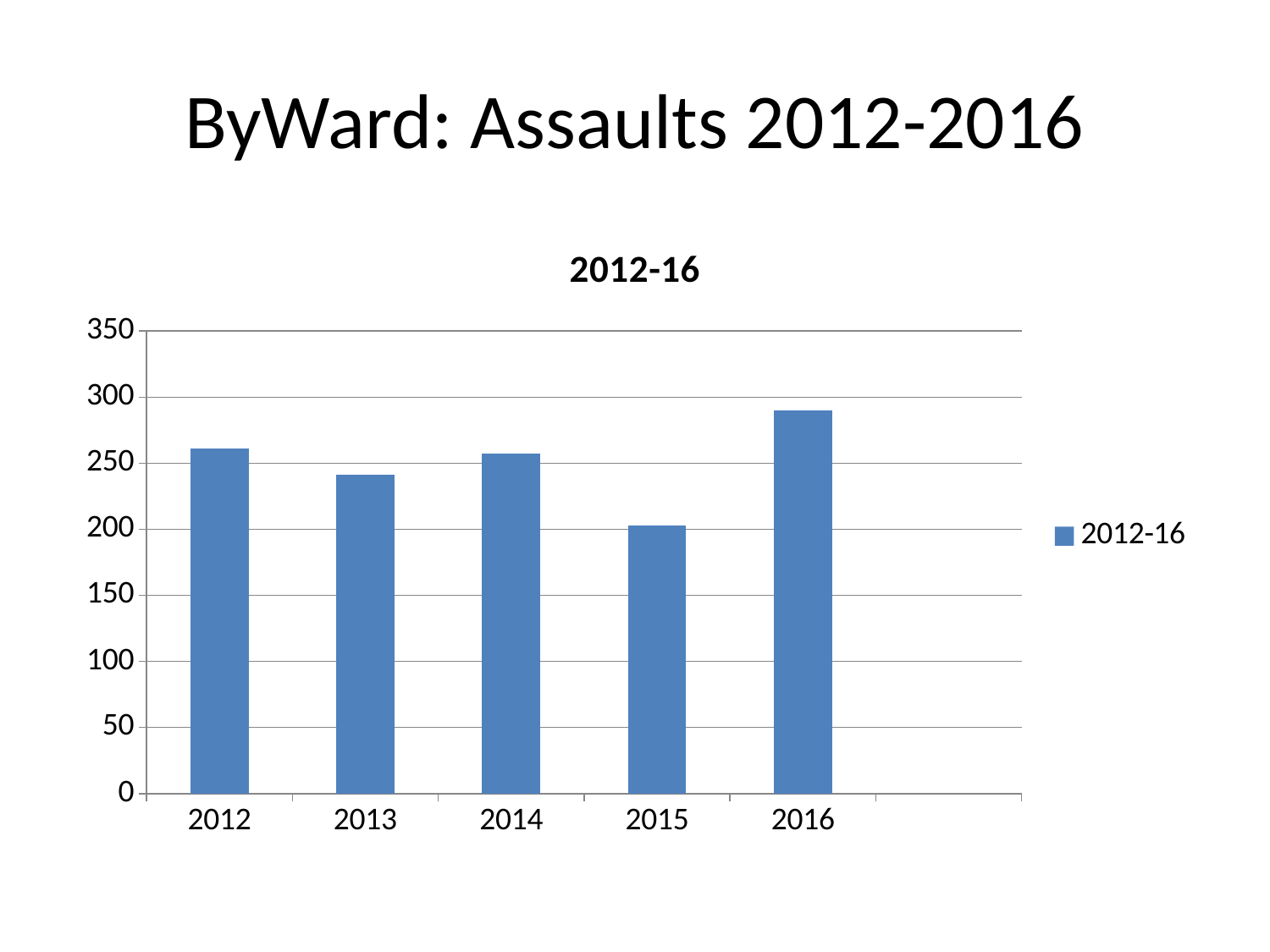
How many series does the legend list? 1 Does the value rise or fall from 2015 to 2016? rise Which year has the larger value, 2012 or 2013? 2012 Is the value for 2016 greater or less than 250? greater Which year has the larger value, 2013 or 2015? 2013 What is the title shown above the chart area? 2012-16 Which year has the highest number of assaults? 2016 Is the value for 2015 greater or less than 250? less What kind of chart is shown on the slide? bar chart Which year has the lowest number of assaults? 2015 How many years are plotted on the x axis of the chart? 5 Is the value for 2012 greater or less than 300? less